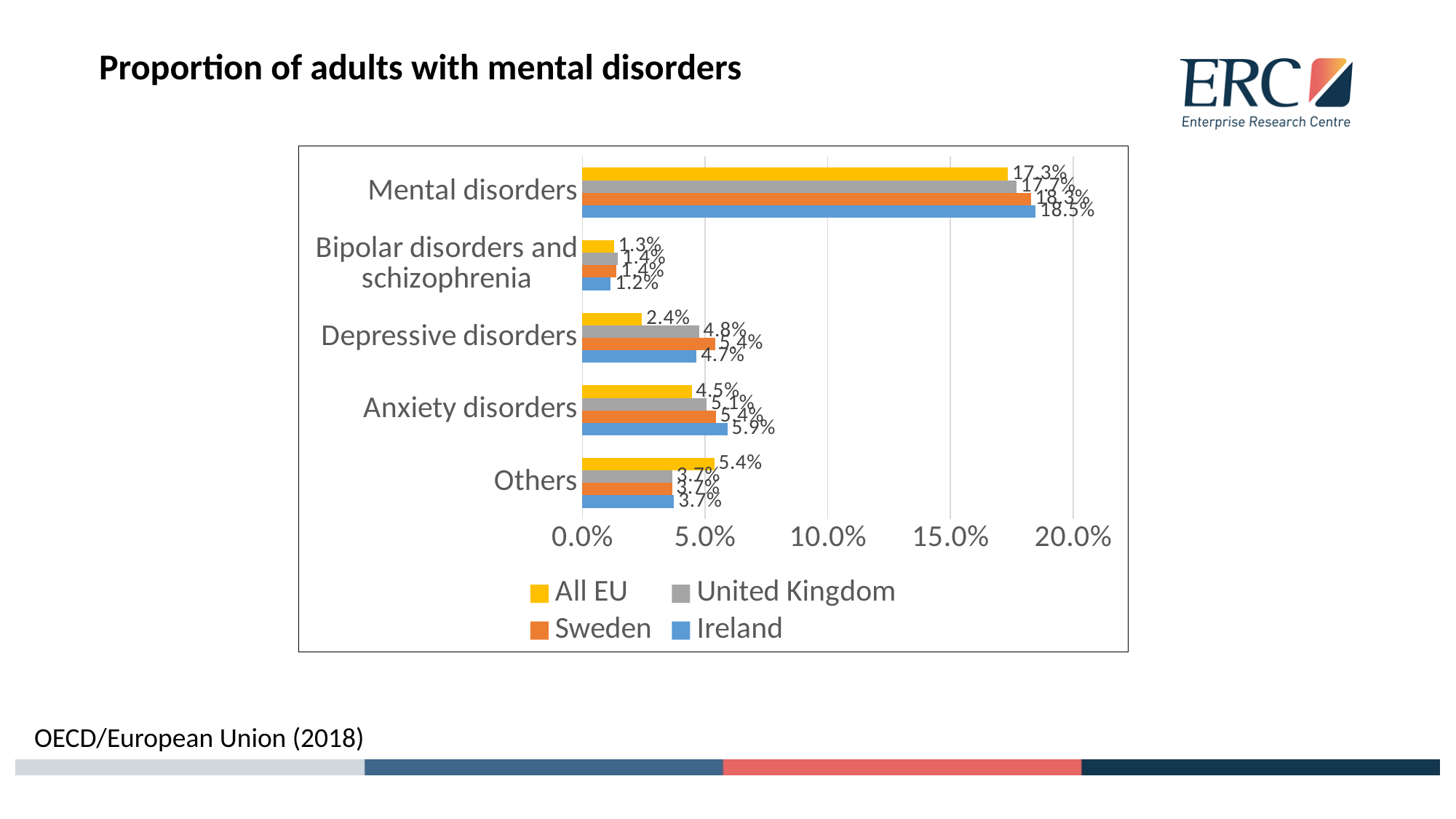
What is the value for Ireland in the Bipolar disorders and schizophrenia category? 1.2% In the Depressive disorders category, which is larger: the United Kingdom value or the All EU value? United Kingdom What is the value for All EU in the Mental disorders category? 17.3% Which category has the lowest value for All EU? Bipolar disorders and schizophrenia Which category has the highest value for Ireland? Mental disorders How many series does the legend list? 4 What is the value for Ireland in the Mental disorders category? 18.5% What is the value for Ireland in the Anxiety disorders category? 5.9% What is the value for All EU in the Depressive disorders category? 2.4% What is the difference between the Ireland and All EU values in the Mental disorders category? 1.2% What kind of chart is shown on the slide? Bar chart What is the value for All EU in the Others category? 5.4%